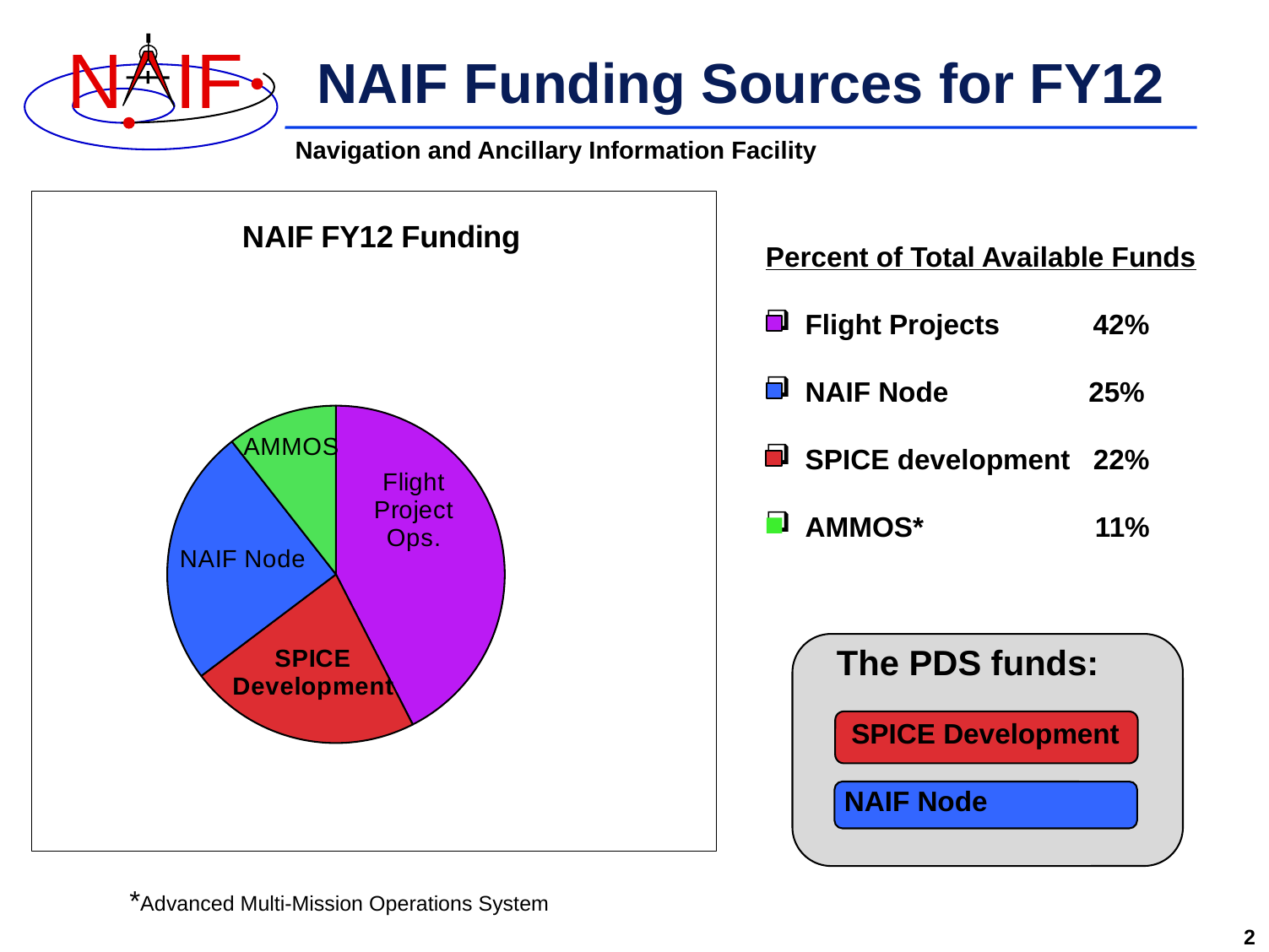
What share of total available funds comes from the NAIF Node? 25% What share of total available funds comes from SPICE development? 22% What share of total available funds comes from AMMOS? 11% What colour is the Flight Project Ops. slice in the pie chart? purple How many slices does the pie chart have? 4 What kind of chart is shown on the slide? pie chart Which slice of the pie chart is the largest? Flight Project Ops. Which is larger, the NAIF Node slice or the AMMOS slice? NAIF Node What is the title of the chart? NAIF FY12 Funding What is the difference in percentage points between the Flight Projects share and the NAIF Node share? 17% Which slice of the pie chart is the smallest? AMMOS